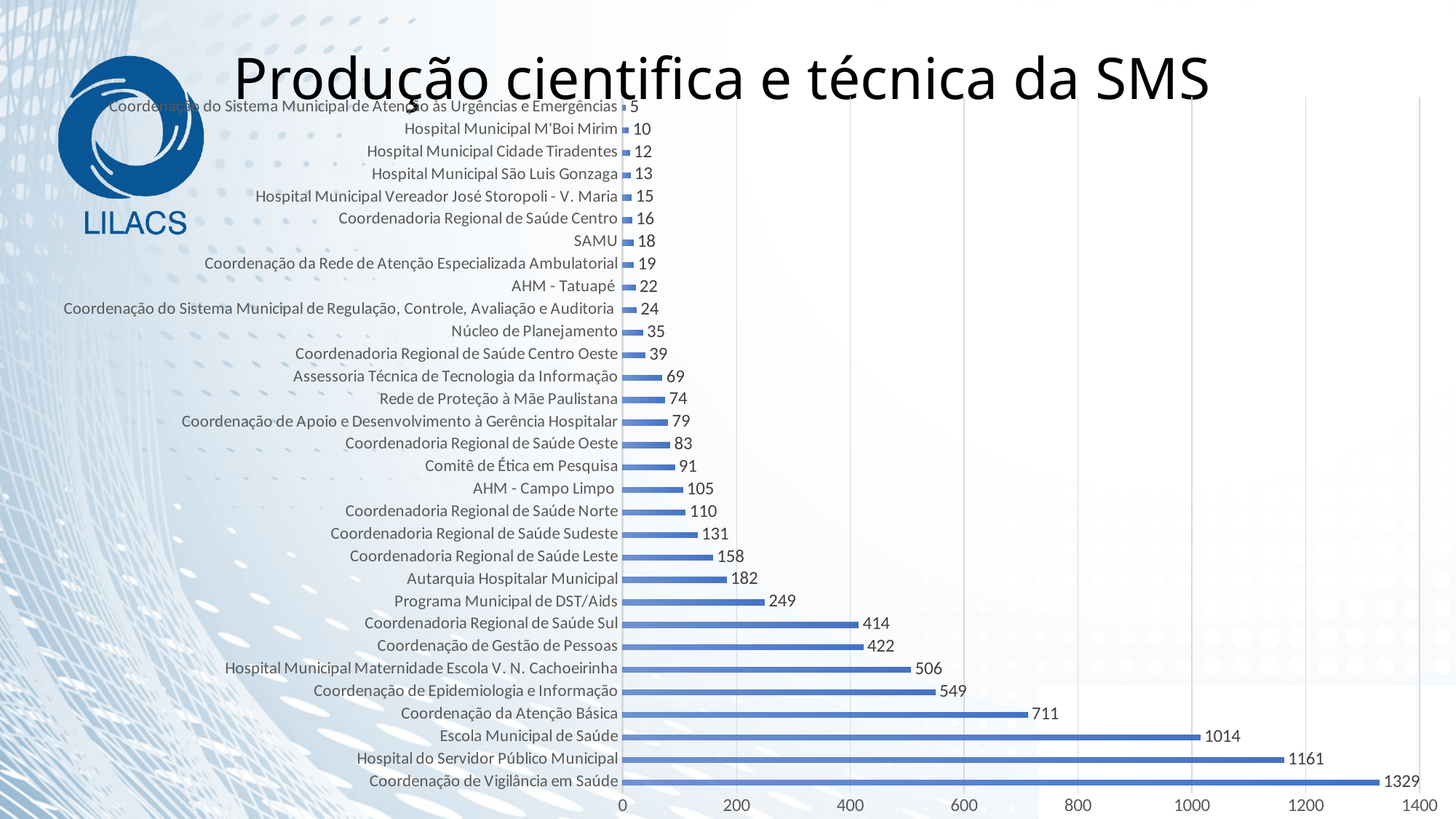
Which is larger, the value for Coordenação da Atenção Básica or the value for Coordenação de Epidemiologia e Informação? Coordenação da Atenção Básica Which category has the highest value? Coordenação de Vigilância em Saúde What is the title of the slide? Produção cientifica e técnica da SMS What is the value for Programa Municipal de DST/Aids? 249 How many categories are shown in the chart? 31 What kind of chart is shown on the slide? bar chart What is the value for Coordenação de Vigilância em Saúde? 1329 What is the value for Escola Municipal de Saúde? 1014 Which category has the lowest value? Coordenação do Sistema Municipal de Atenção às Urgências e Emergências What is the value for SAMU? 18 What is the difference between the values for Hospital do Servidor Público Municipal and Escola Municipal de Saúde? 147 Is the value for Hospital Municipal Maternidade Escola V. N. Cachoeirinha greater or less than 400? greater